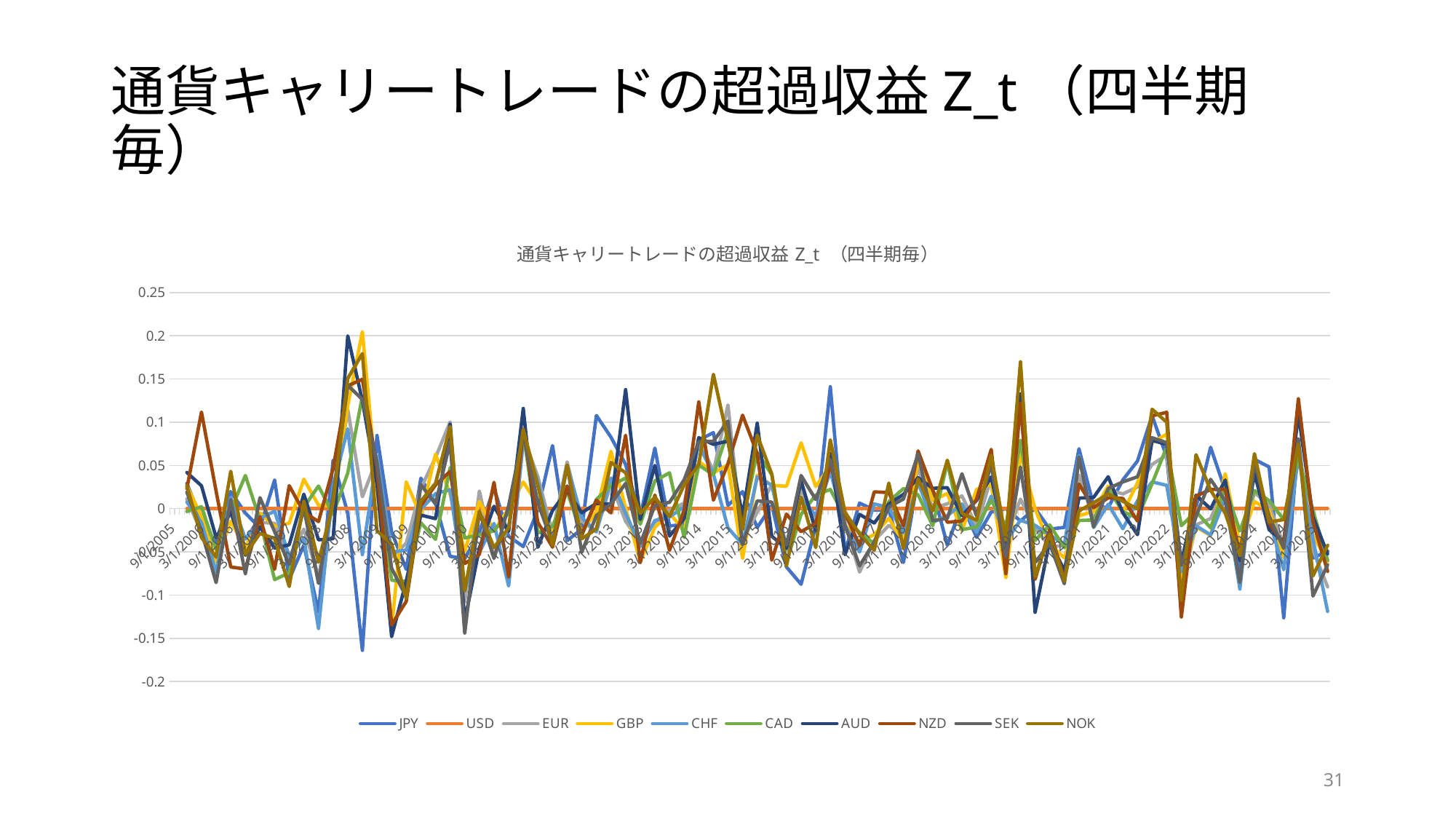
Which series is listed first in the legend? JPY What is the title of the chart? 通貨キャリートレードの超過収益 Z_t （四半期毎） Which series stays flat at 0 across the whole chart? USD Is the peak of the GBP series around 3/1/2009 greater or less than 0.15? greater Which series in the legend is shown in orange? USD What kind of chart is shown on the slide? line chart Is the lowest value of the JPY series (around 3/1/2009) greater or less than -0.1? less How many series does the legend list? 10 Is the peak of the NOK series around 3/1/2020 greater or less than 0.15? greater